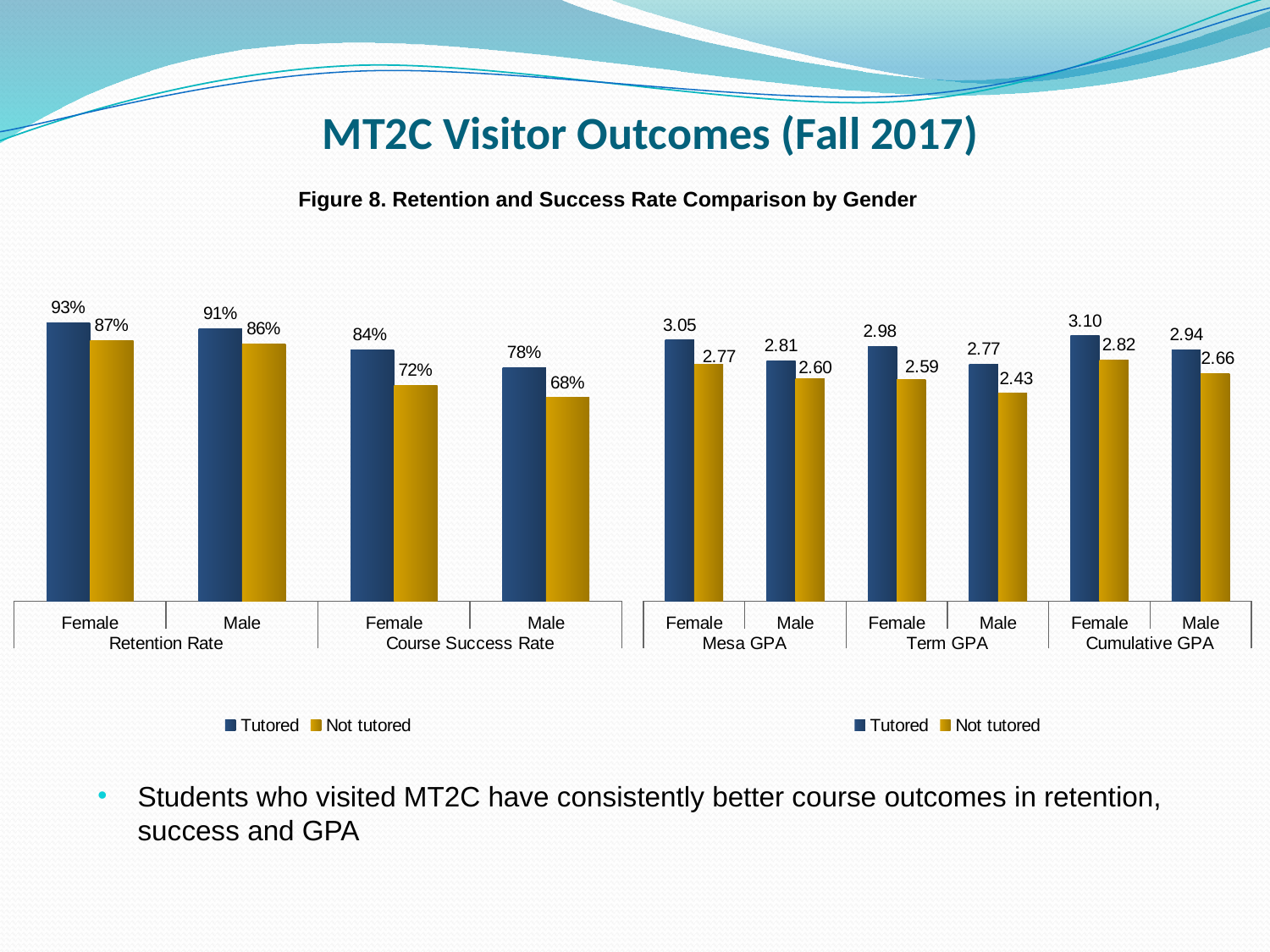
How many series does the legend of the left chart list? 2 In the left chart, what is the difference between the Tutored and Not tutored course success rates for Female students? 12% In the right chart, which group has the lowest value shown? Male Term GPA, Not tutored (2.43) In the right chart, which is higher: the Not tutored Cumulative GPA for Female students or the Tutored Mesa GPA for Male students? Not tutored Cumulative GPA for Female students (2.82) In the right chart, what is the difference between the Tutored and Not tutored Mesa GPA for Male students? 0.21 In the left chart, what is the Tutored retention rate for Female students? 93% In the left chart, which is higher: the Tutored retention rate for Male students or the Tutored course success rate for Female students? Tutored retention rate for Male students (91%) How many category groups (GPA measures) are shown in the right chart? 3 In the right chart, what is the Not tutored Term GPA for Male students? 2.43 In the left chart, what is the Not tutored course success rate for Male students? 68% In the right chart, what is the Tutored Cumulative GPA for Female students? 3.10 What type of chart is the left chart? Bar chart